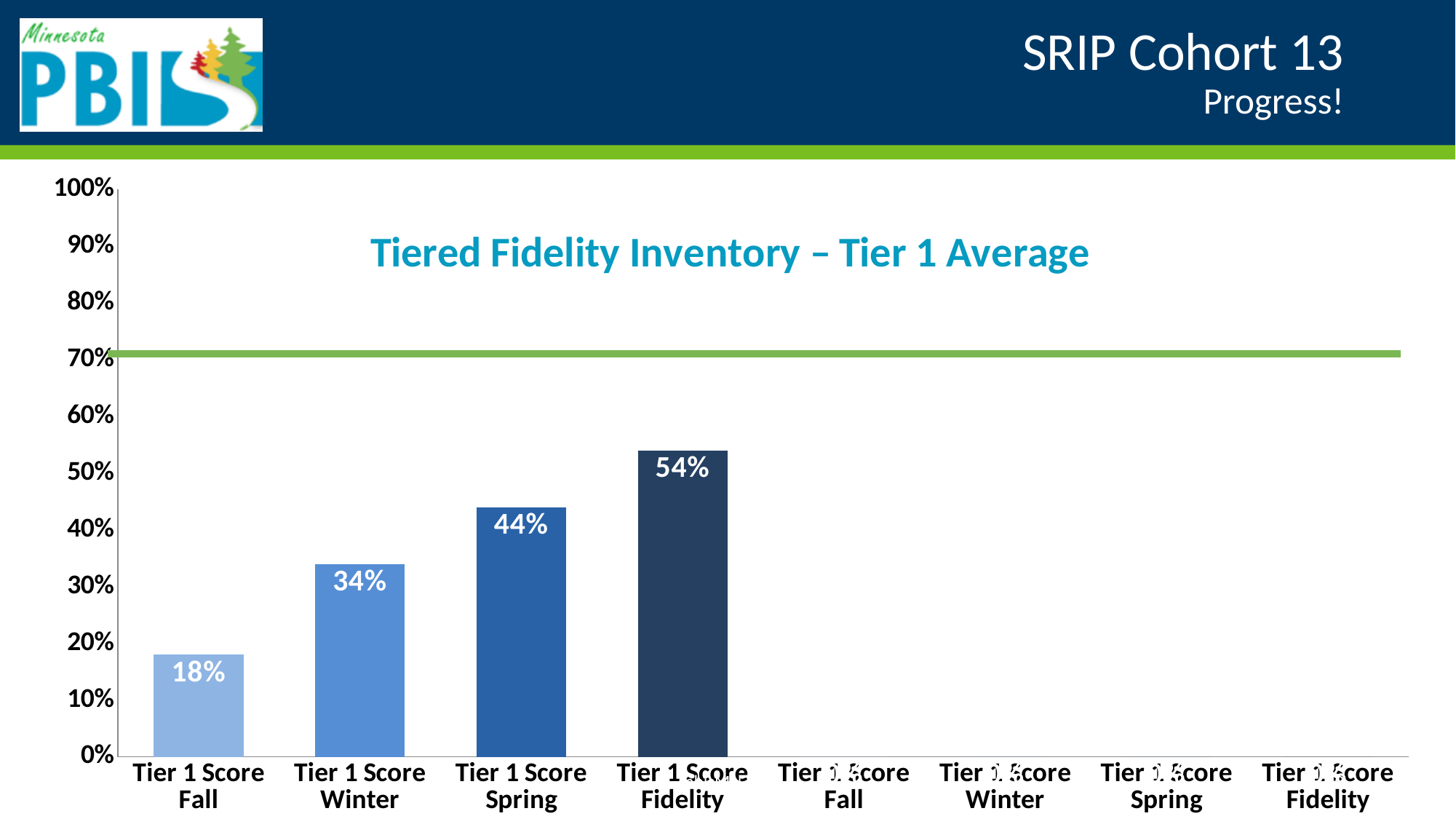
What kind of chart is shown on the slide? bar chart What is the difference between the Tier 1 Score Fidelity value and the Tier 1 Score Fall value? 36% What is the value for Tier 1 Score Winter? 34% Is the value for Tier 1 Score Fidelity greater or less than 70%? less How many bars are plotted on the chart? 4 Which bar has the lowest value? Tier 1 Score Fall Which is larger, the Tier 1 Score Winter value or the Tier 1 Score Spring value? Tier 1 Score Spring Which bar has the highest value? Tier 1 Score Fidelity What is the value for Tier 1 Score Spring? 44% What is the value for Tier 1 Score Fidelity? 54% What is the value for Tier 1 Score Fall? 18% Do the bar values rise or fall from Tier 1 Score Fall to Tier 1 Score Fidelity? rise